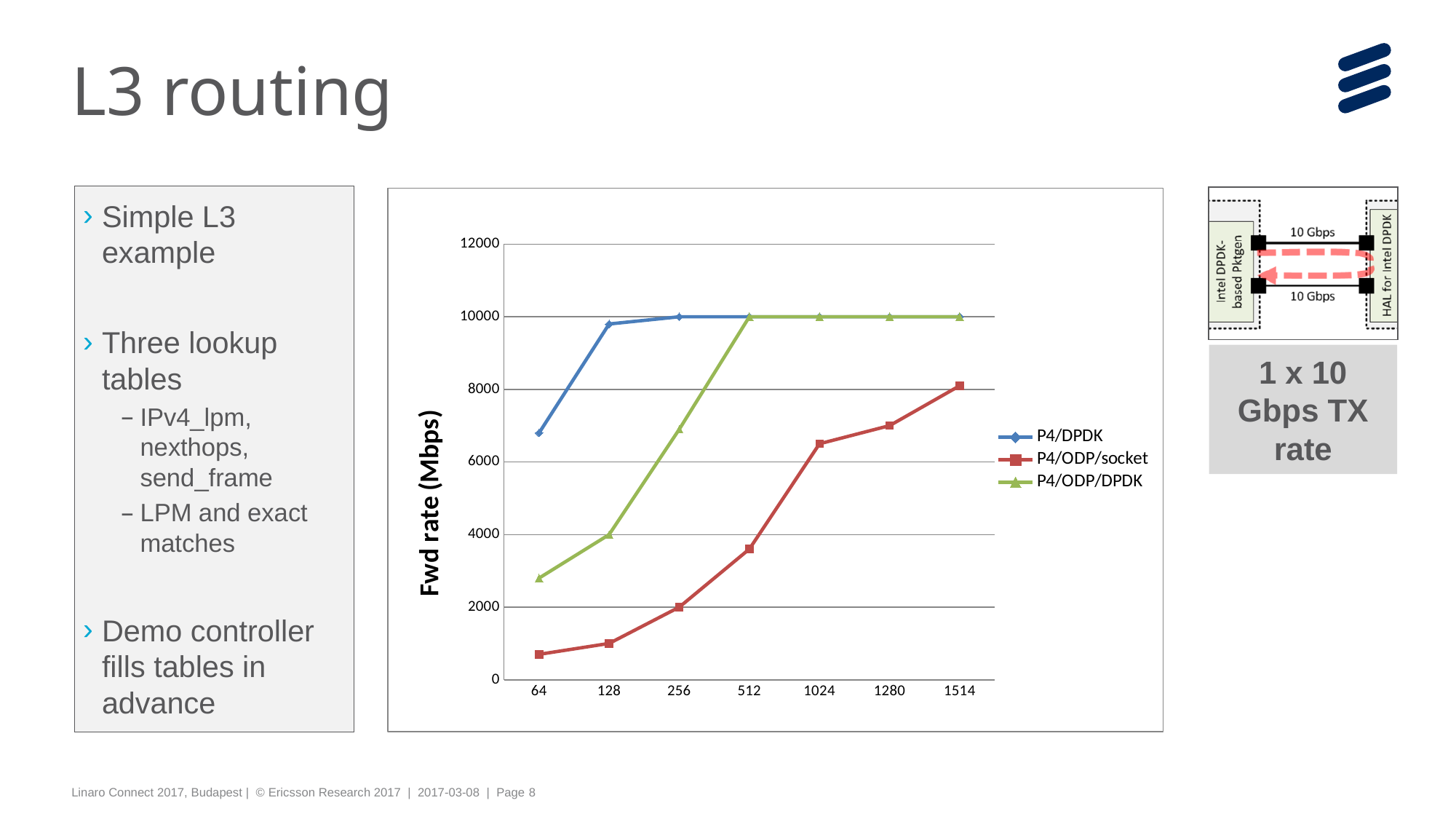
Is the value for P4/ODP/socket at packet size 64 greater or less than 2000? less How many series does the chart legend list? 3 At packet size 128, which is larger: the value for P4/DPDK or the value for P4/ODP/socket? P4/DPDK What is the forwarding rate for P4/ODP/DPDK at packet size 1024? 10000 What is the y-axis title of the chart? Fwd rate (Mbps) What is the forwarding rate for P4/DPDK at packet size 512? 10000 What kind of chart is shown on the slide? line chart Is the value for P4/DPDK at packet size 64 greater or less than 6000? greater Does the P4/ODP/socket series rise or fall as packet size increases along the x axis? rise Which series has the lowest forwarding rate at packet size 64? P4/ODP/socket Is the value for P4/ODP/DPDK at packet size 64 greater or less than 2000? greater How many packet-size categories are shown on the x axis of the chart? 7